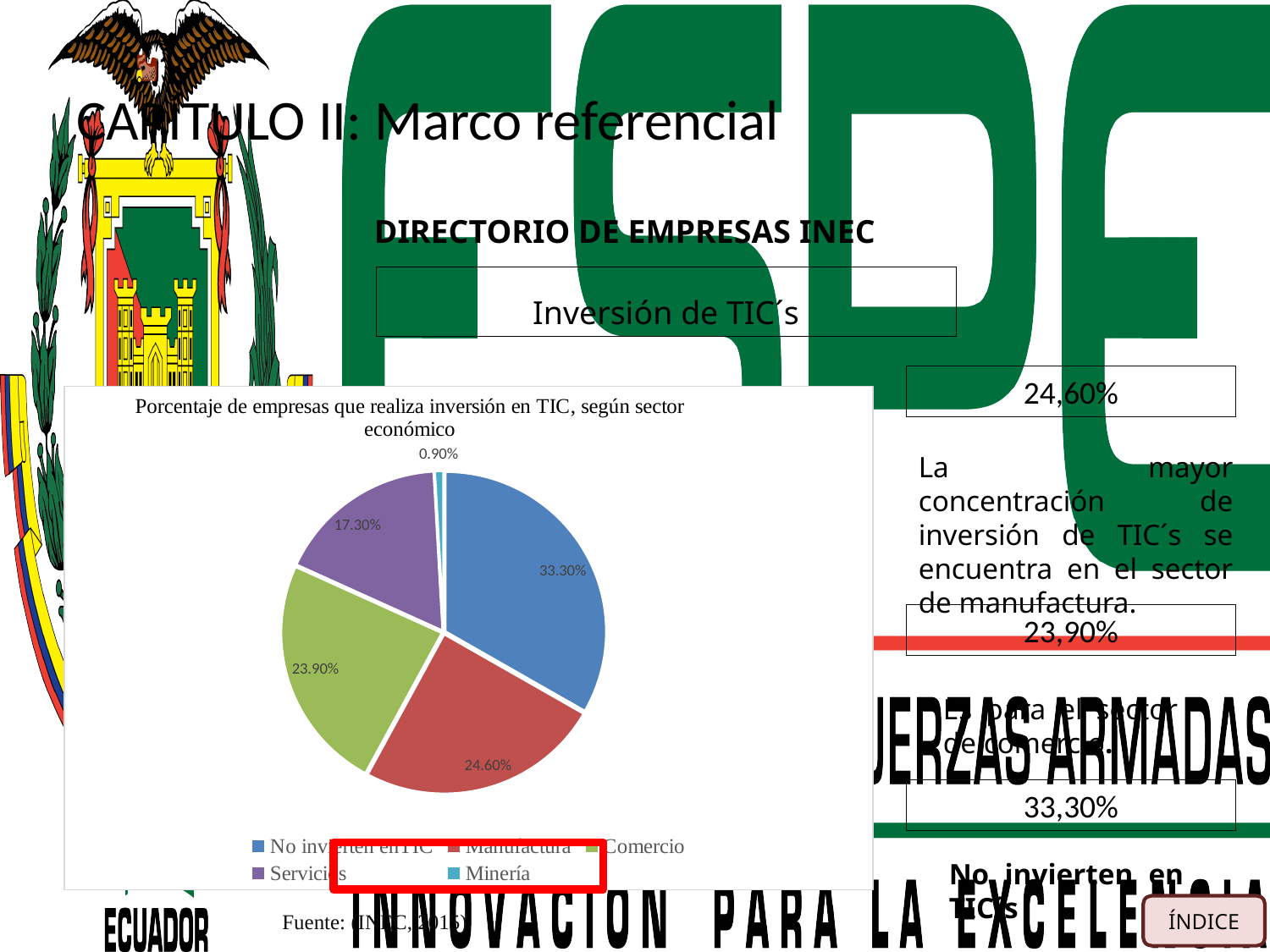
What percentage is shown for the Manufactura slice? 24.60% Which category has the largest slice of the pie? No invierten en TIC Which is larger, the Manufactura slice or the Servicios slice? Manufactura What percentage is shown for the 'No invierten en TIC' slice? 33.30% What percentage is shown for the Minería slice? 0.90% What percentage is shown for the Servicios slice? 17.30% What percentage is shown for the Comercio slice? 23.90% What is the title of the chart? Porcentaje de empresas que realiza inversión en TIC, según sector económico What type of chart is shown on the slide? pie chart Which category has the smallest slice of the pie? Minería How many categories does the legend list? 5 What is the difference between the Manufactura and Servicios percentages? 7.30%